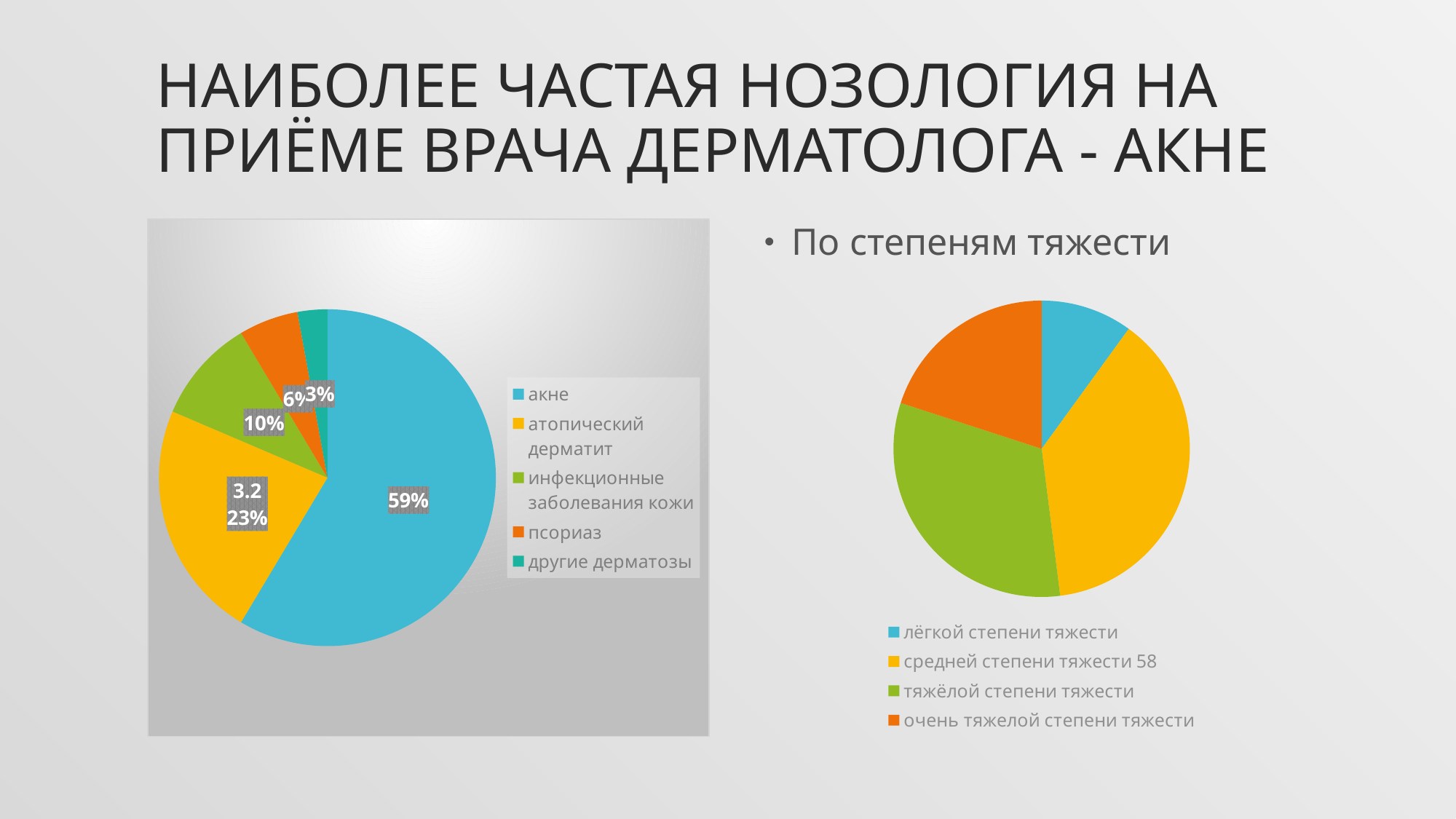
In the right pie chart (По степеням тяжести), which category has the largest slice? средней степени тяжести 58 In the left pie chart, what percentage is shown for акне? 59% In the left pie chart, which category has the smallest slice? другие дерматозы What type of chart is used on the right side of the slide (По степеням тяжести)? pie chart In the right pie chart (По степеням тяжести), which category has the smallest slice? лёгкой степени тяжести In the left pie chart, what percentage is shown for атопический дерматит? 23% How many categories does the left pie chart's legend list? 5 In the left pie chart, what is the difference in percentage points between акне and атопический дерматит? 36 In the left pie chart, what percentage is shown for псориаз? 6% In the left pie chart, what percentage is shown for инфекционные заболевания кожи? 10% In the left pie chart, which category has the largest slice? акне In the left pie chart, which is larger: инфекционные заболевания кожи or псориаз? инфекционные заболевания кожи